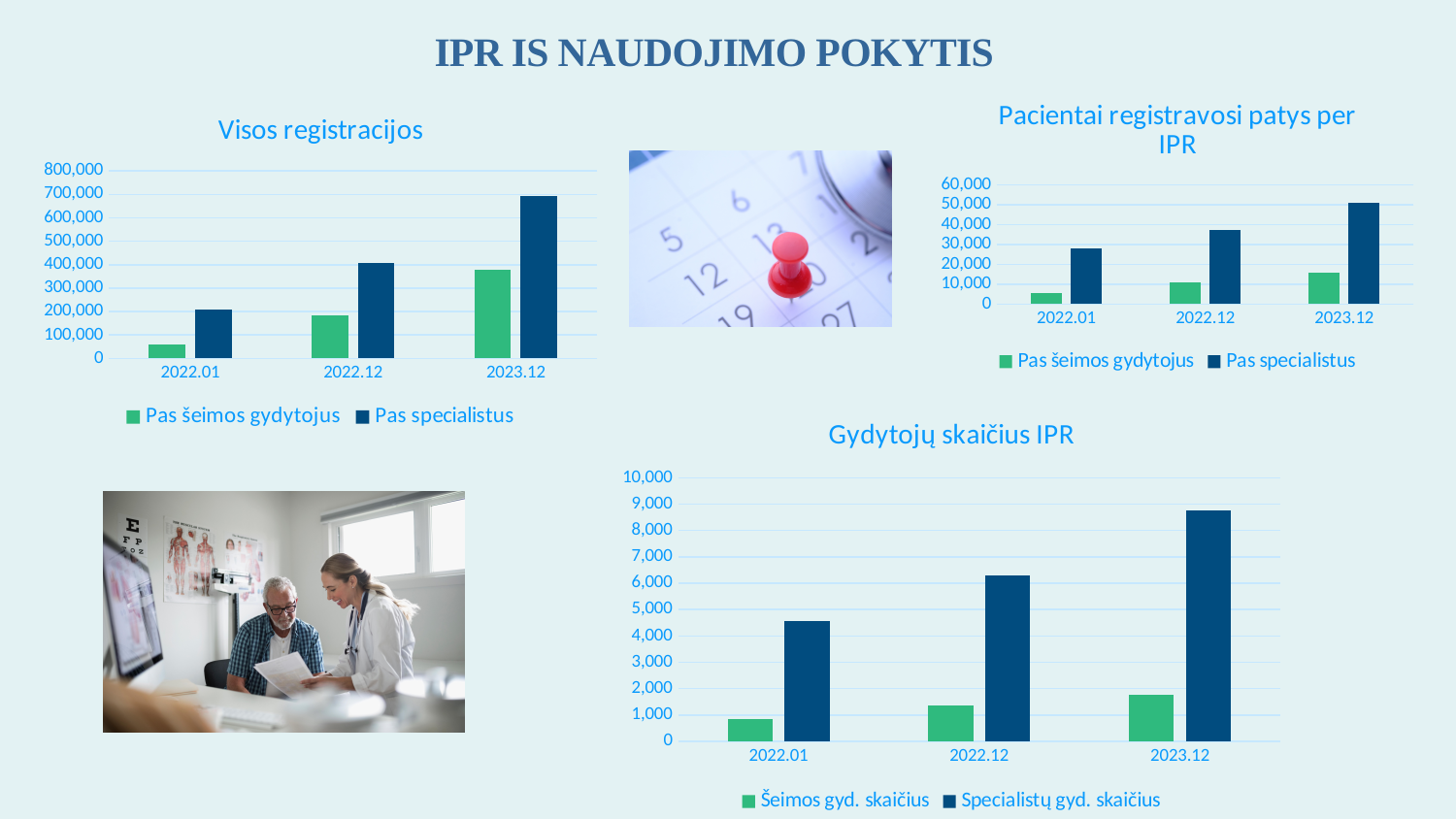
How many periods are shown on the x axis of the 'Gydytojų skaičius IPR' chart? 3 How many series does the legend of the 'Pacientai registravosi patys per IPR' chart list? 2 In the 'Pacientai registravosi patys per IPR' chart, which is larger in 2022.12: 'Pas šeimos gydytojus' or 'Pas specialistus'? Pas specialistus In the 'Visos registracijos' chart, is the value for 'Pas specialistus' in 2023.12 greater or less than 600,000? greater In the 'Pacientai registravosi patys per IPR' chart, is the value for 'Pas specialistus' in 2023.12 greater or less than 40,000? greater In the 'Visos registracijos' chart, is the value for 'Pas šeimos gydytojus' in 2022.01 greater or less than 100,000? less What kind of chart is 'Gydytojų skaičius IPR'? bar chart In the 'Visos registracijos' chart, which period has the lowest value for 'Pas šeimos gydytojus'? 2022.01 In the 'Visos registracijos' chart, do the 'Pas specialistus' values rise or fall from 2022.01 to 2023.12? rise In the 'Visos registracijos' chart, which period has the highest value for 'Pas specialistus'? 2023.12